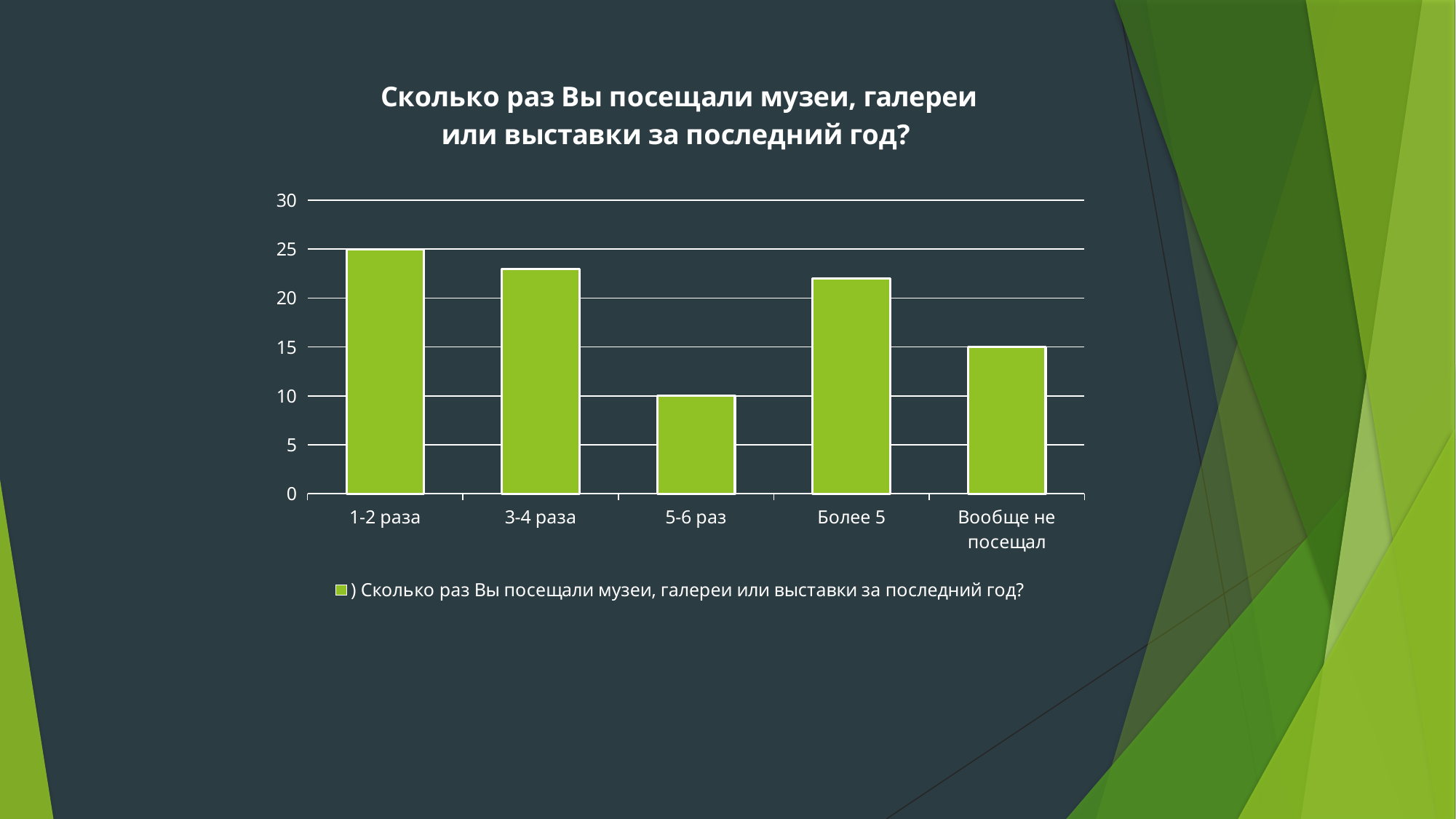
What is the value for the category "1-2 раза"? 25 Which category has the lowest value? 5-6 раз What is the value for the category "5-6 раз"? 10 Which is larger: the value for "1-2 раза" or the value for "Вообще не посещал"? 1-2 раза What is the difference between the values for "1-2 раза" and "5-6 раз"? 15 What type of chart is shown on the slide? bar chart Is the value for "3-4 раза" greater or less than 20? greater How many series does the chart's legend list? 1 What is the value for the category "Вообще не посещал"? 15 How many categories are shown on the x axis of the chart? 5 Is the value for "Более 5" greater or less than 25? less Which category has the highest value? 1-2 раза